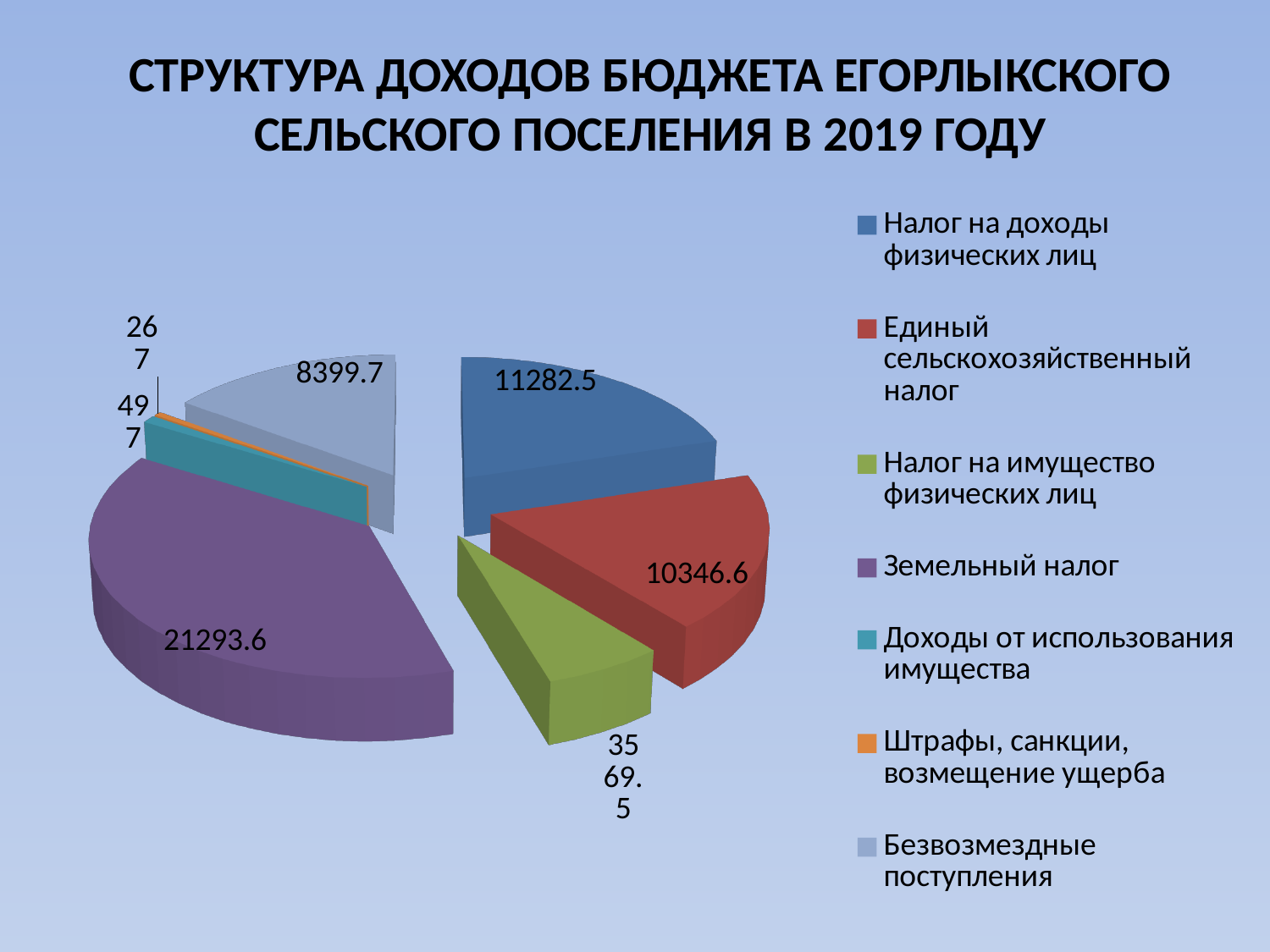
What is the difference between Земельный налог and Налог на доходы физических лиц? 10011.1 How many categories does the pie chart show? 7 What is the value for Налог на доходы физических лиц? 11282.5 What is the value for Единый сельскохозяйственный налог? 10346.6 Which category has the smallest slice of the pie? Штрафы, санкции, возмещение ущерба What is the value for Безвозмездные поступления? 8399.7 Which is larger: Налог на доходы физических лиц or Единый сельскохозяйственный налог? Налог на доходы физических лиц What type of chart is shown on the slide? Pie chart What colour is the slice for Земельный налог? Purple What is the value for Земельный налог? 21293.6 Which category has the largest slice of the pie? Земельный налог What is the difference between Налог на доходы физических лиц and Единый сельскохозяйственный налог? 935.9